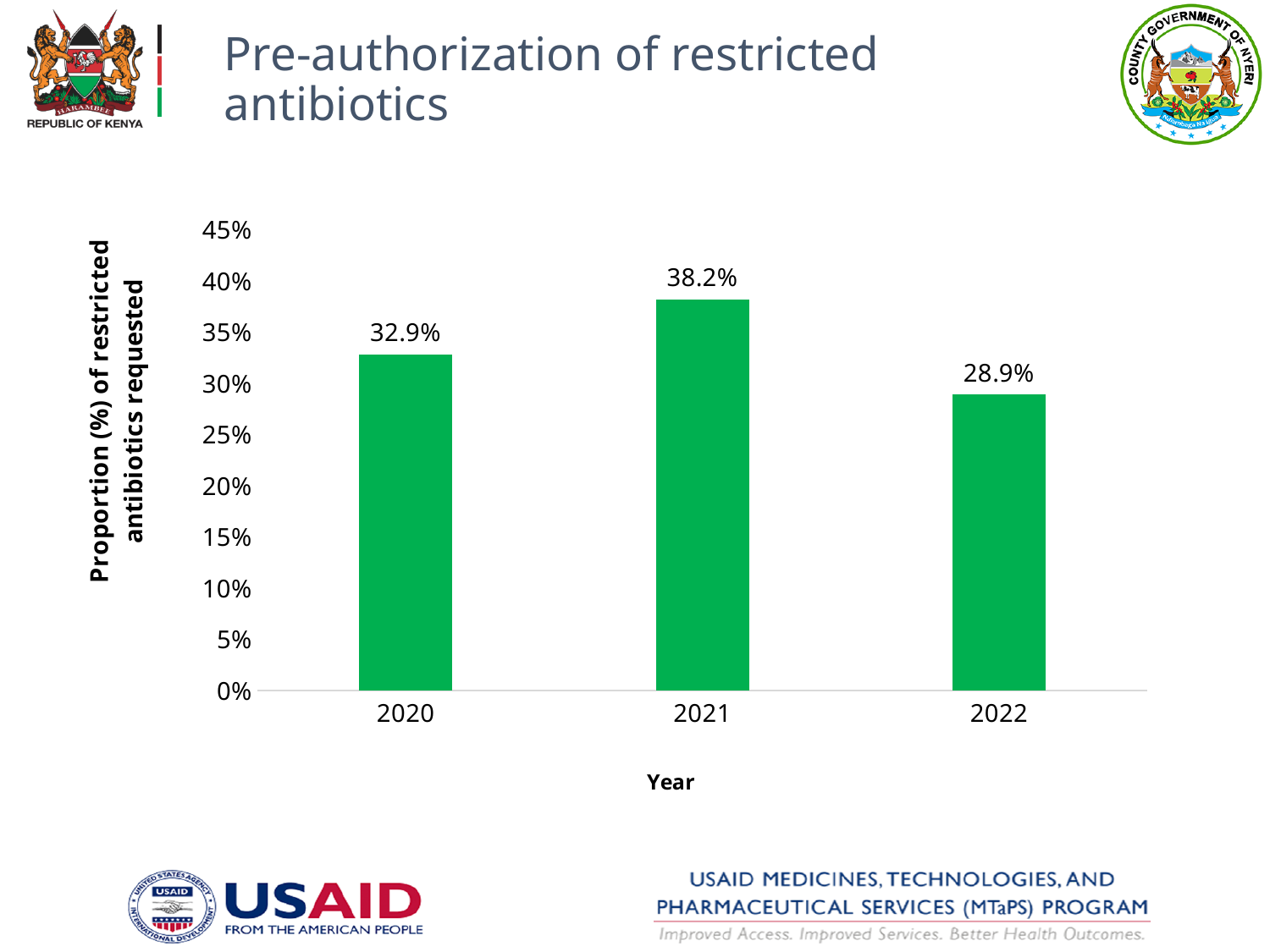
What is the proportion of restricted antibiotics requested in 2021? 38.2% What is the proportion of restricted antibiotics requested in 2022? 28.9% What is the difference between the 2021 and 2020 values? 5.3% What kind of chart is shown on the slide? bar chart What is the proportion of restricted antibiotics requested in 2020? 32.9% Is the value for 2021 greater or less than 35%? greater What is the difference between the 2020 and 2022 values? 4.0% How many years are shown on the x axis? 3 Which year has the highest proportion of restricted antibiotics requested? 2021 Which year has the lowest proportion of restricted antibiotics requested? 2022 Which year has a larger value, 2020 or 2022? 2020 What is the label of the y axis? Proportion (%) of restricted antibiotics requested